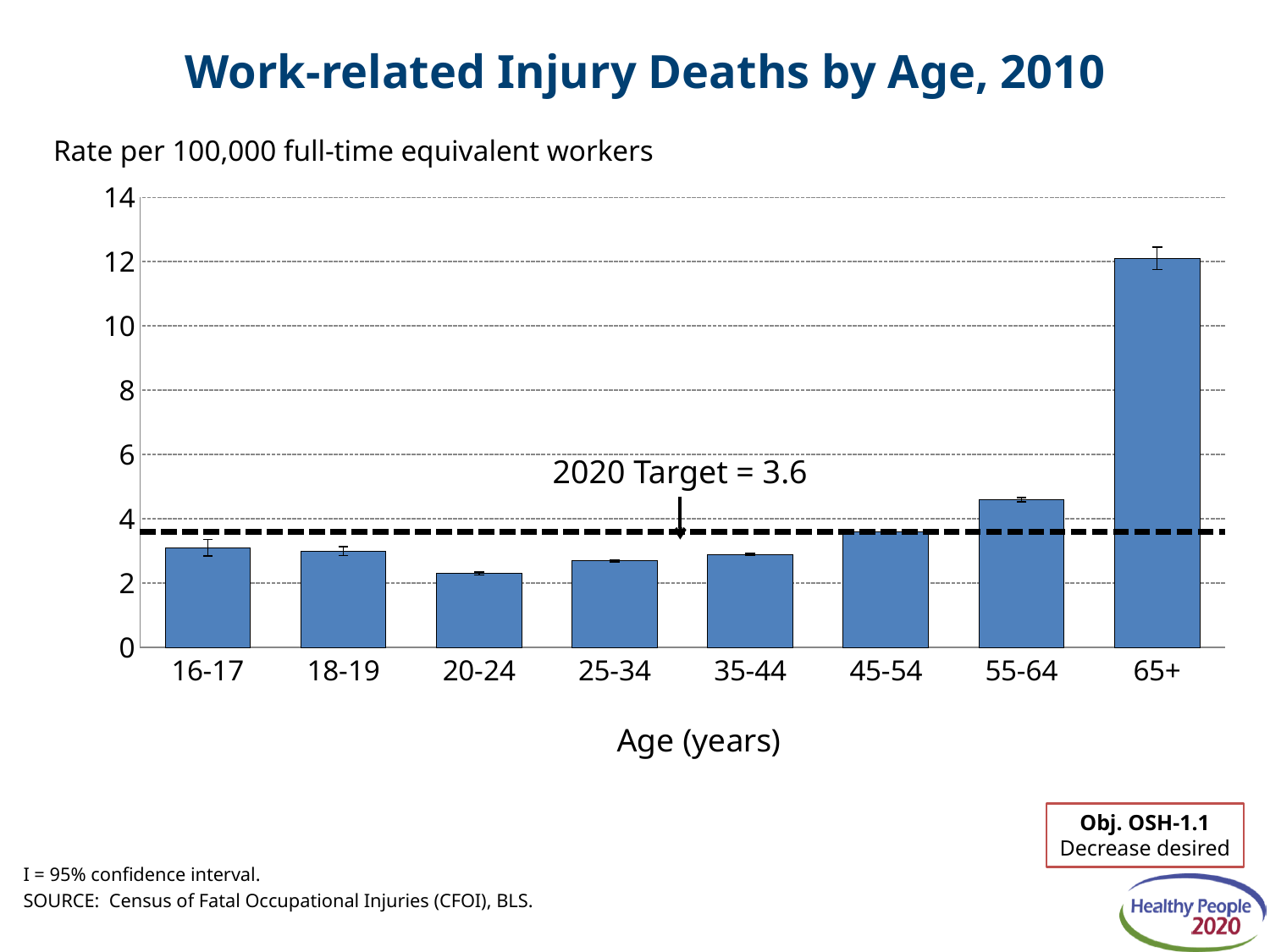
What unit is the rate measured in, according to the label above the chart? Rate per 100,000 full-time equivalent workers Is the value for the 55-64 age group greater or less than 4? greater What kind of chart is shown on the slide? bar chart Which age group has the highest work-related injury death rate? 65+ Is the value for the 16-17 age group greater or less than 4? less Which age group has the lowest work-related injury death rate? 20-24 What is the 2020 Target value shown on the chart? 3.6 Which age group has a higher rate, 55-64 or 45-54? 55-64 How many age groups are shown on the x axis? 8 Is the value for the 20-24 age group greater or less than 2? greater What is the title of the chart? Work-related Injury Deaths by Age, 2010